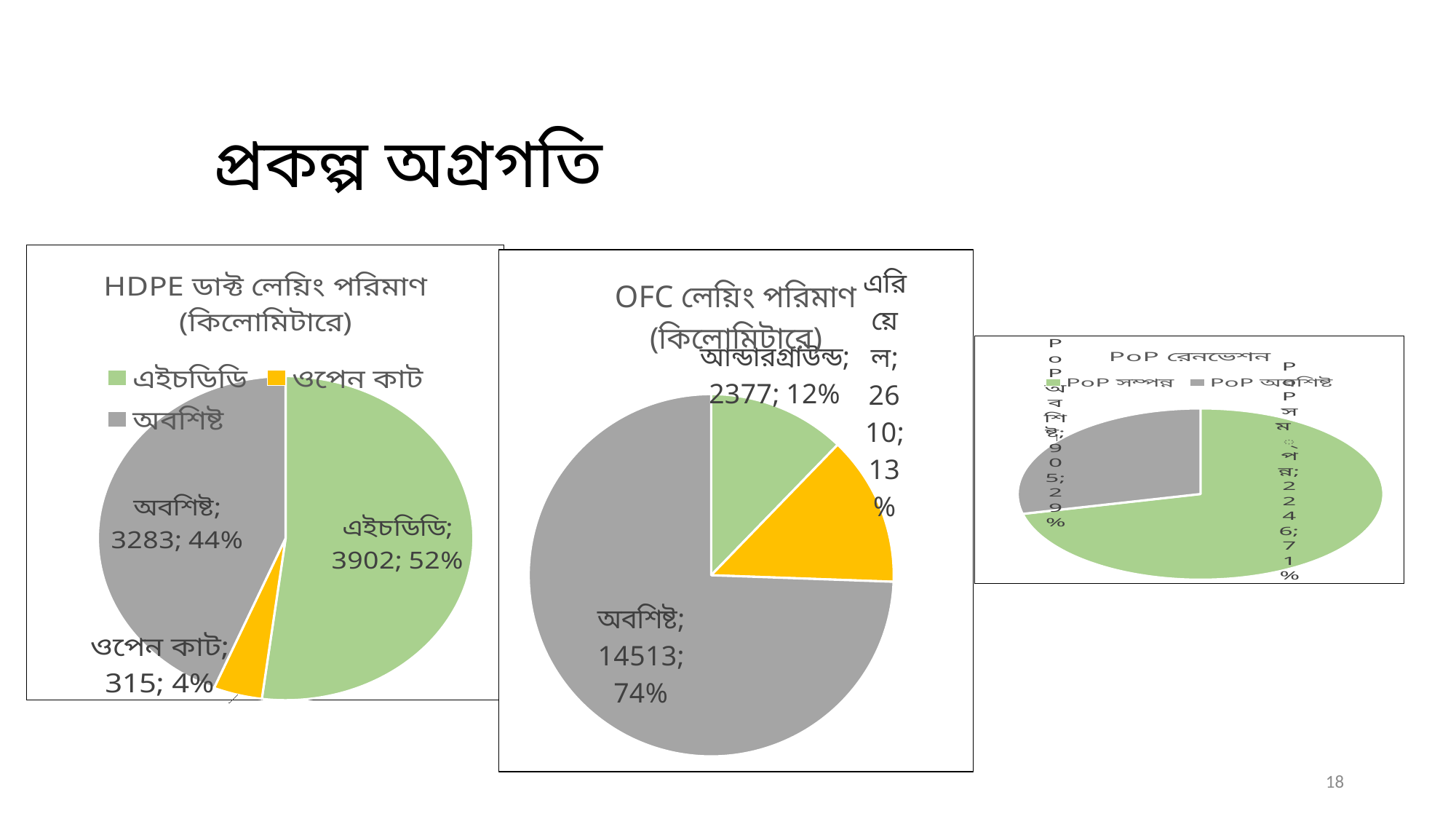
How many series does the legend of the 'PoP রেনভেশন' chart list? 2 How many slices does the 'HDPE ডাক্ট লেয়িং পরিমাণ (কিলোমিটারে)' pie chart have? 3 In the 'OFC লেয়িং পরিমাণ (কিলোমিটারে)' chart, which is larger, আন্ডারগ্রাউন্ড or এরিয়েল? এরিয়েল In the 'OFC লেয়িং পরিমাণ (কিলোমিটারে)' chart, what is the value for অবশিষ্ট? 14513 In the 'HDPE ডাক্ট লেয়িং পরিমাণ (কিলোমিটারে)' chart, what share of the pie is ওপেন কাট? 4% In the 'HDPE ডাক্ট লেয়িং পরিমাণ (কিলোমিটারে)' chart, which category is the smallest? ওপেন কাট In the 'OFC লেয়িং পরিমাণ (কিলোমিটারে)' chart, which category is the largest? অবশিষ্ট In the 'HDPE ডাক্ট লেয়িং পরিমাণ (কিলোমিটারে)' chart, what is the difference between এইচডিডি and অবশিষ্ট? 619 What kind of chart is the 'HDPE ডাক্ট লেয়িং পরিমাণ (কিলোমিটারে)' chart? Pie chart In the 'HDPE ডাক্ট লেয়িং পরিমাণ (কিলোমিটারে)' chart, what is the value for এইচডিডি? 3902 In the 'PoP রেনভেশন' chart, what share of the pie is PoP সম্পন্ন? 71% In the 'OFC লেয়িং পরিমাণ (কিলোমিটারে)' chart, what share of the pie is আন্ডারগ্রাউন্ড? 12%